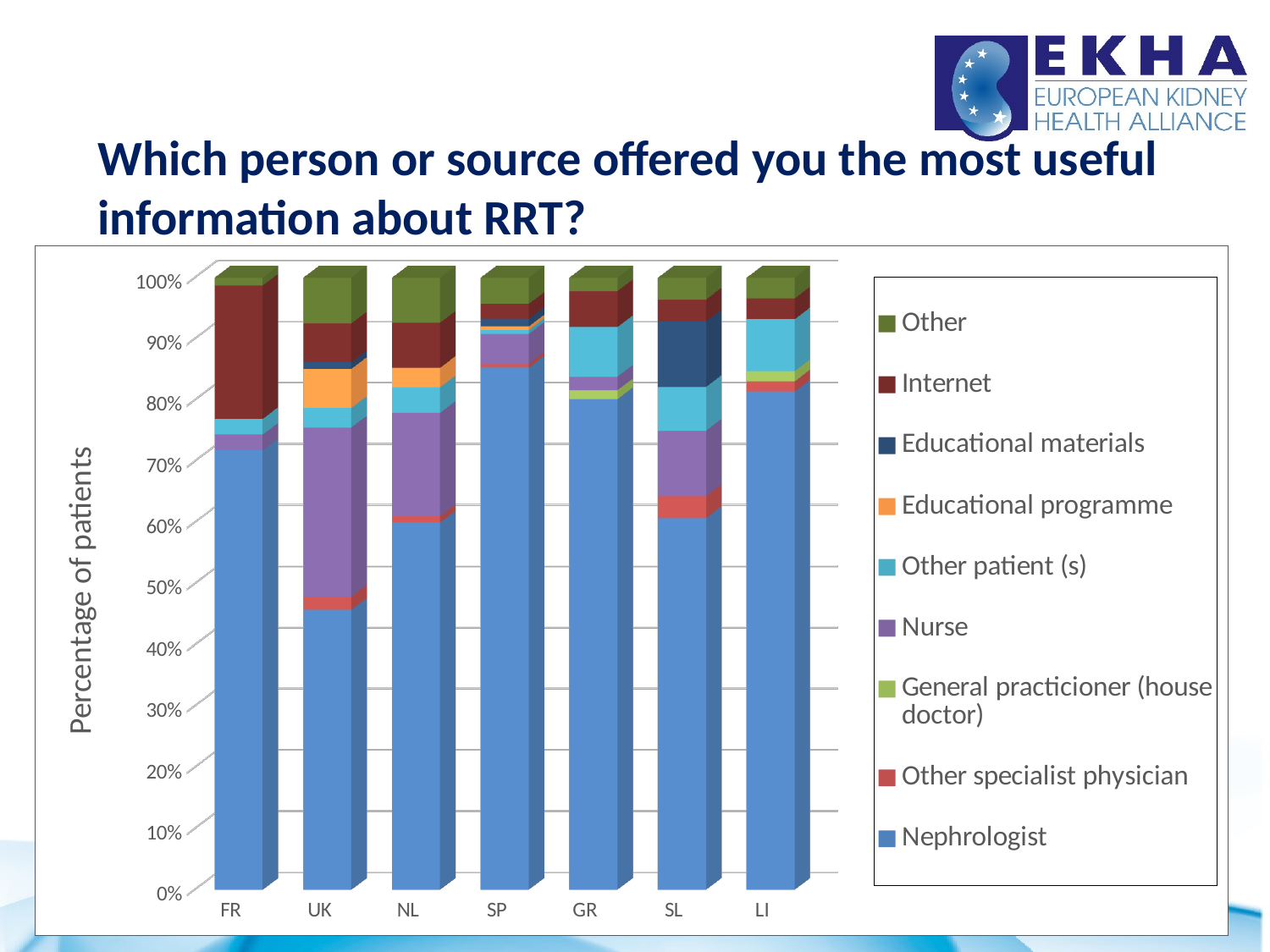
How many countries (categories) are shown on the x axis? 7 Is the Nephrologist share for UK greater or less than 50%? less Which country has the lowest share for Nephrologist? UK Which country has the largest Educational materials segment? SL Which country has the highest share for Nephrologist? SP What kind of chart is shown on the slide? stacked bar chart Which country has the largest Internet segment? FR Which is larger, the Nephrologist share for UK or for SP? SP Is the Nephrologist share for SP greater or less than 80%? greater What is the label of the vertical axis? Percentage of patients How many series does the legend list? 9